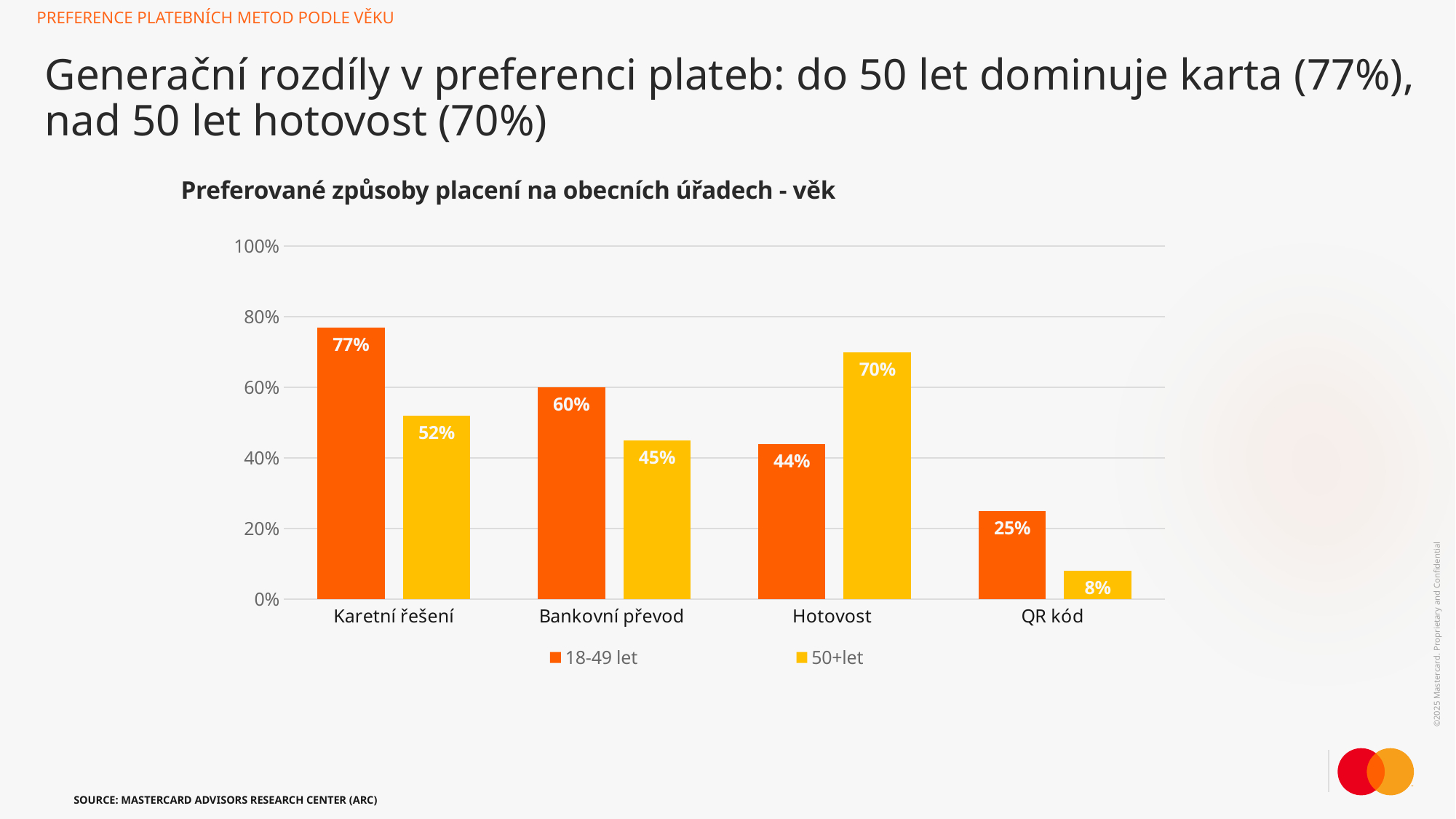
What is the difference between the 18-49 let and 50+let values for Karetní řešení? 25% Which category has the highest value in the 18-49 let series? Karetní řešení What is the title of the chart? Preferované způsoby placení na obecních úřadech - věk Which is larger for Hotovost: the 18-49 let value or the 50+let value? 50+let How many categories are shown on the x axis? 4 How many series does the legend list? 2 What is the value for Bankovní převod in the 18-49 let series? 60% What is the value for QR kód in the 50+let series? 8% What kind of chart is shown on the slide? Bar chart Which category has the lowest value in the 50+let series? QR kód What is the value for Hotovost in the 50+let series? 70% What is the value for Karetní řešení in the 18-49 let series? 77%